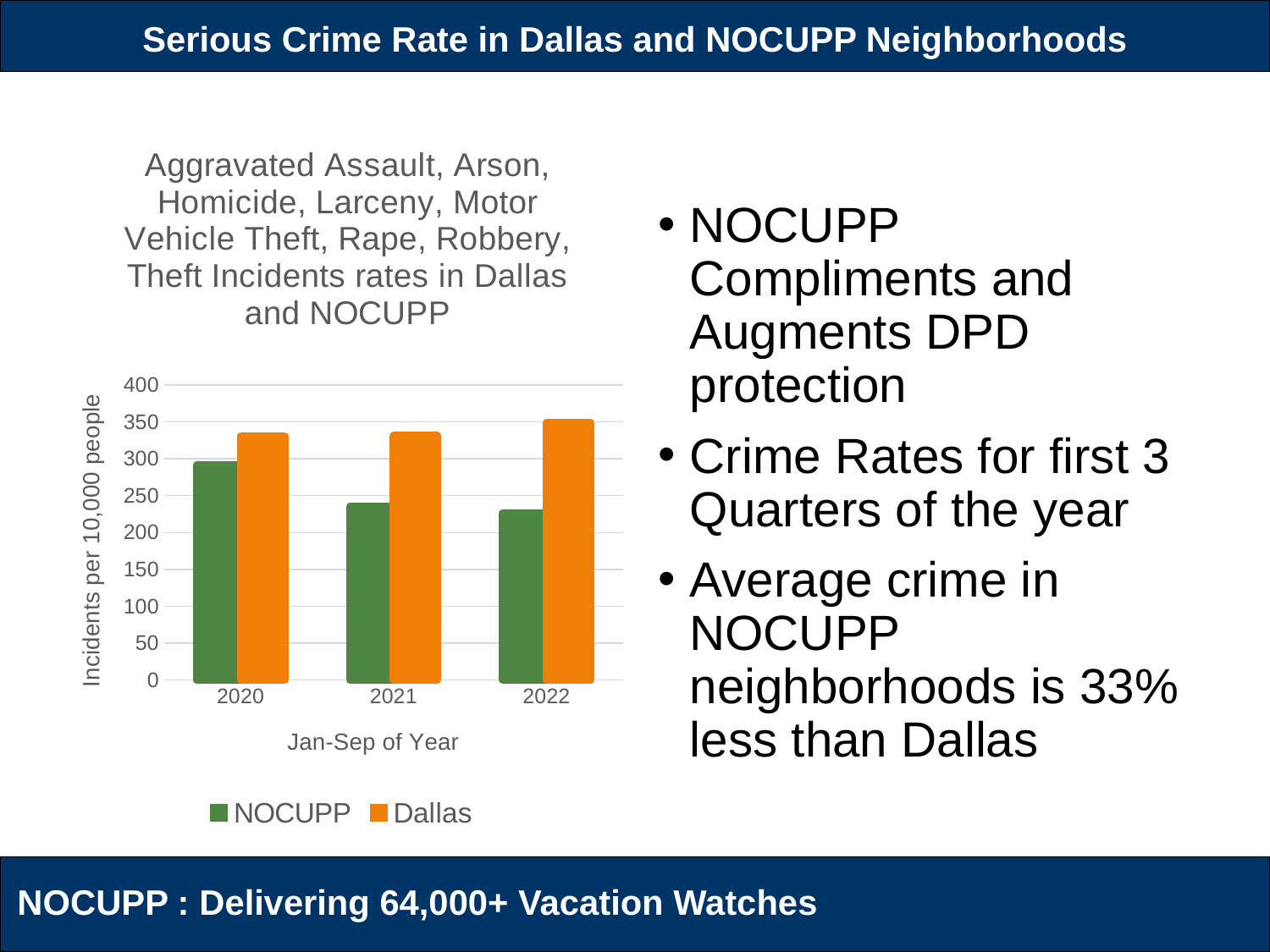
Do the NOCUPP values rise or fall from 2020 to 2022? fall What kind of chart is shown on the slide? bar chart How many series does the chart legend list? 2 Is the NOCUPP value for 2022 greater or less than 250? less In which year is the NOCUPP value highest? 2020 Is the NOCUPP value for 2021 greater or less than 300? less How many years are shown on the x axis of the chart? 3 In 2020, which is larger, the NOCUPP value or the Dallas value? Dallas Is the Dallas value for 2022 greater or less than 300? greater What is the label on the y axis of the chart? Incidents per 10,000 people In 2022, which is larger, the NOCUPP value or the Dallas value? Dallas